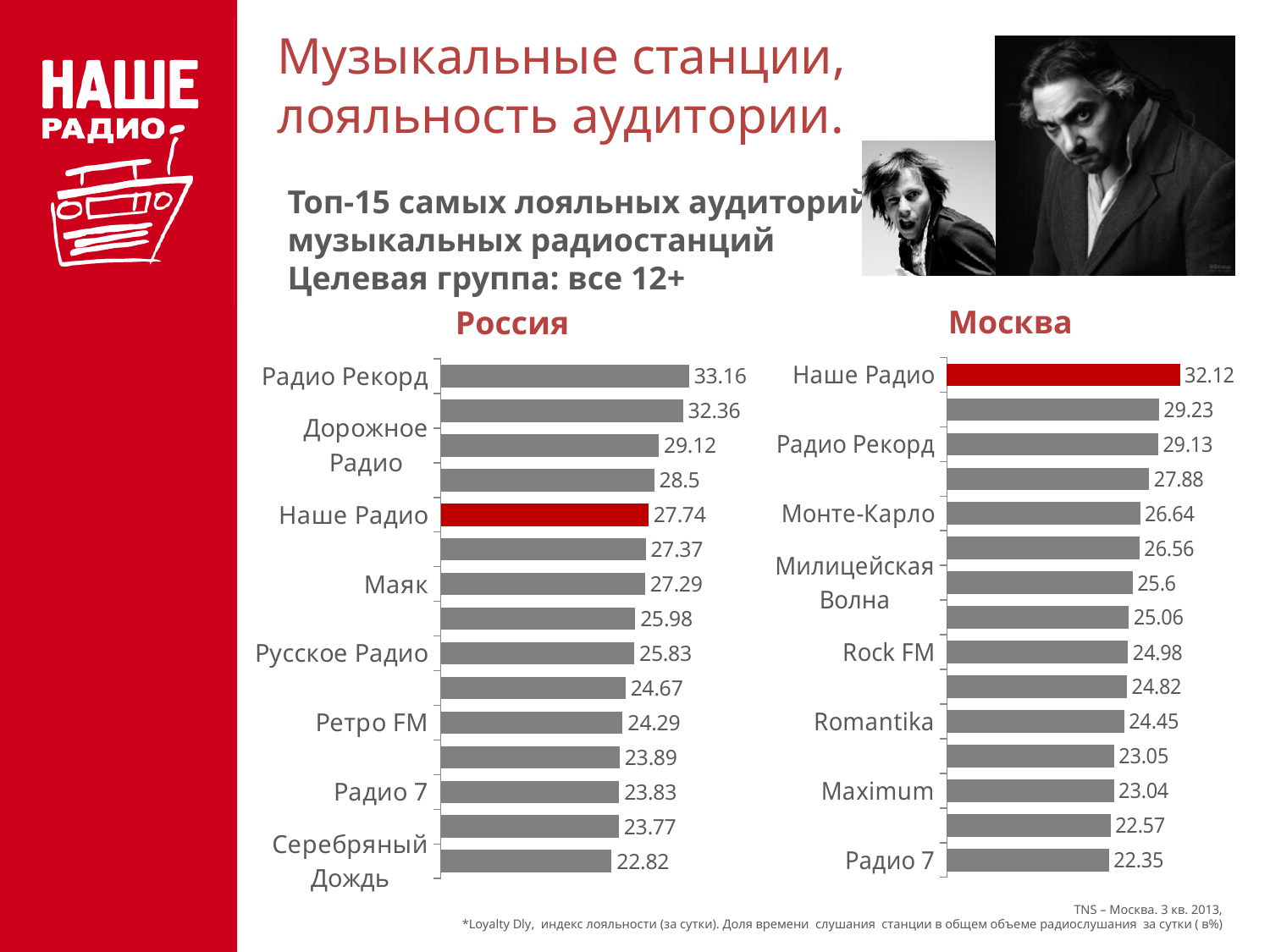
What is the difference between the value for Наше Радио in the Москва chart and in the Россия chart? 4.38 How many bars are in the Россия chart? 15 In both charts, which station's bar is coloured red? Наше Радио In the Москва chart, which station has the highest value? Наше Радио What type of chart is used for the Москва data? Bar chart Is the value for Радио Рекорд higher in the Россия chart or in the Москва chart? Россия In the Россия chart, what is the value for Наше Радио? 27.74 In the Москва chart, what is the lowest value shown? 22.35 In the Россия chart, which station has the highest value? Радио Рекорд In the Россия chart, which station has the lowest value? Серебряный Дождь In the Москва chart, what is the value for Rock FM? 24.98 In the Москва chart, what is the value for Наше Радио? 32.12